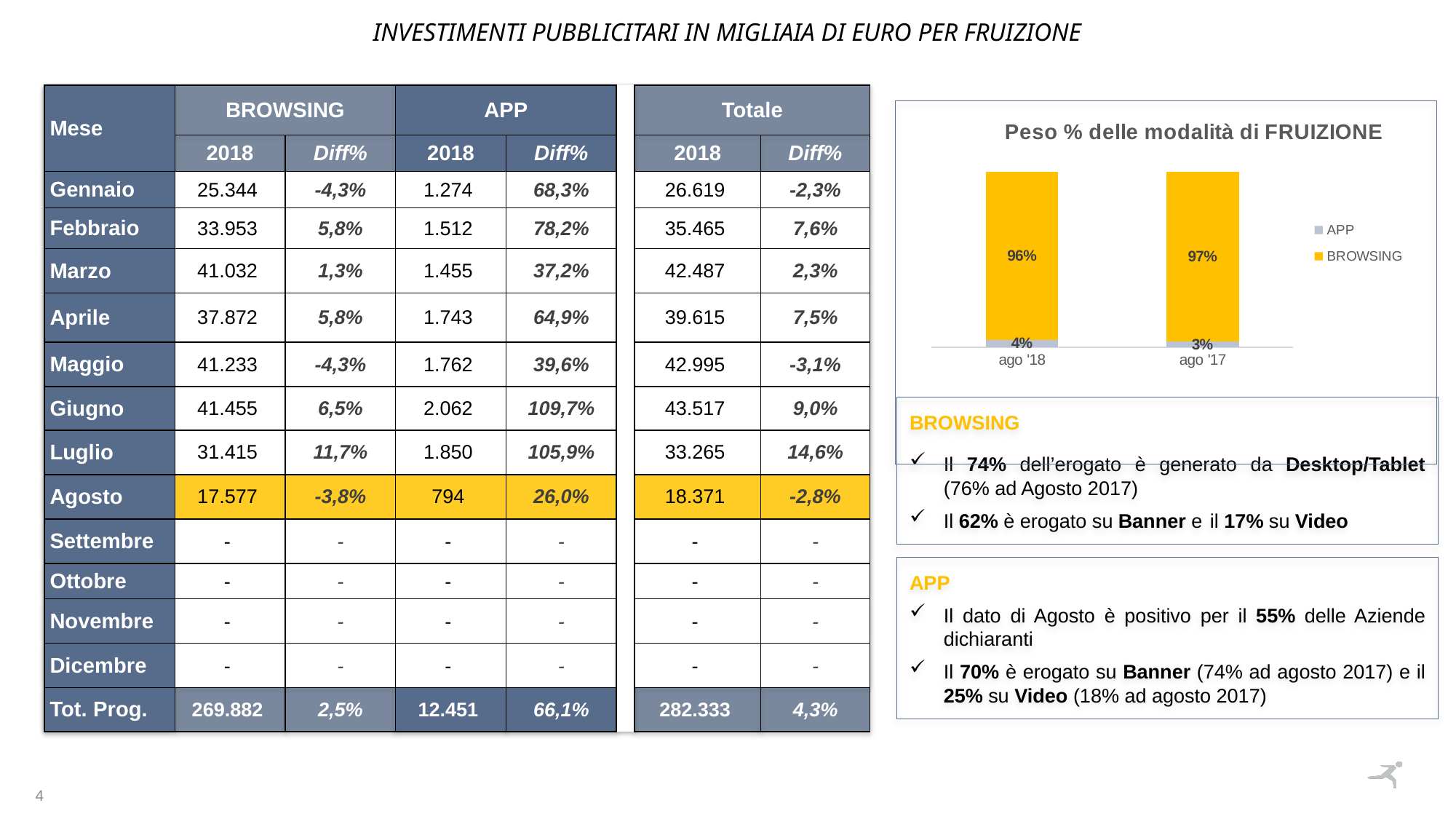
What is the title of the chart on the slide? Peso % delle modalità di FRUIZIONE What is the APP share for ago '18 in the chart? 4% Which colour represents BROWSING in the chart legend? yellow What is the BROWSING share for ago '17 in the chart? 97% What is the difference between the BROWSING share for ago '17 and for ago '18 in the chart? 1% How many categories are shown on the x axis of the chart? 2 What is the APP share for ago '17 in the chart? 3% In the chart, which category has the higher BROWSING share, ago '18 or ago '17? ago '17 What kind of chart is shown on the slide? stacked bar chart What is the BROWSING share for ago '18 in the chart? 96% How many series does the chart legend list? 2 In the chart, which category has the higher APP share? ago '18